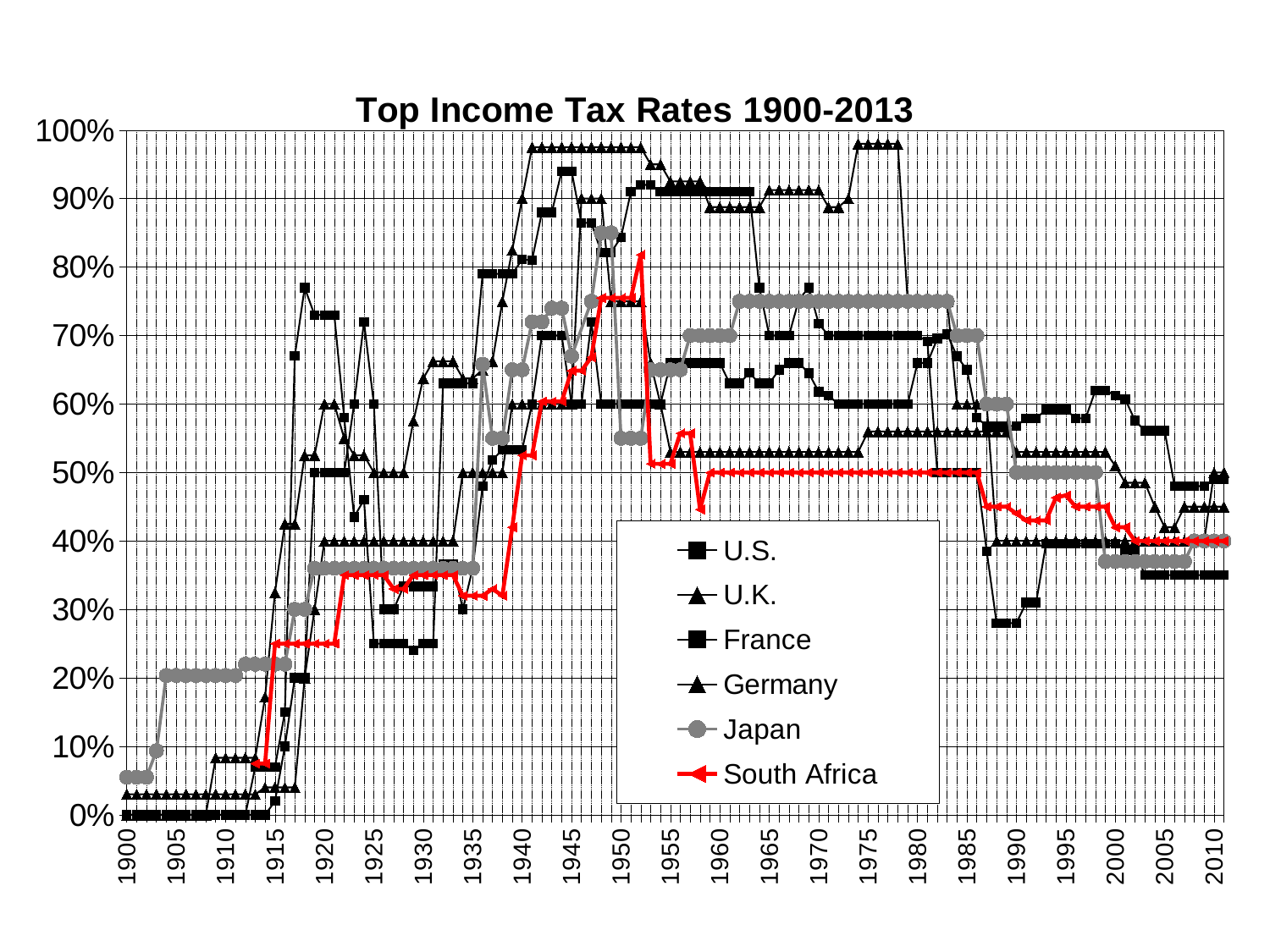
Which series is drawn in red? South Africa What kind of chart is shown on the slide? line chart Is the value for Japan in 1975 greater or less than 70%? greater Is the value for Japan in 1940 greater or less than 60%? greater Is the value for Japan in 2005 greater or less than 40%? less Does the value for Japan rise or fall from 1975 to 2010? fall What is the title of the chart? Top Income Tax Rates 1900-2013 In 1975, which is larger, the value for Japan or the value for South Africa? Japan How many series does the legend list? 6